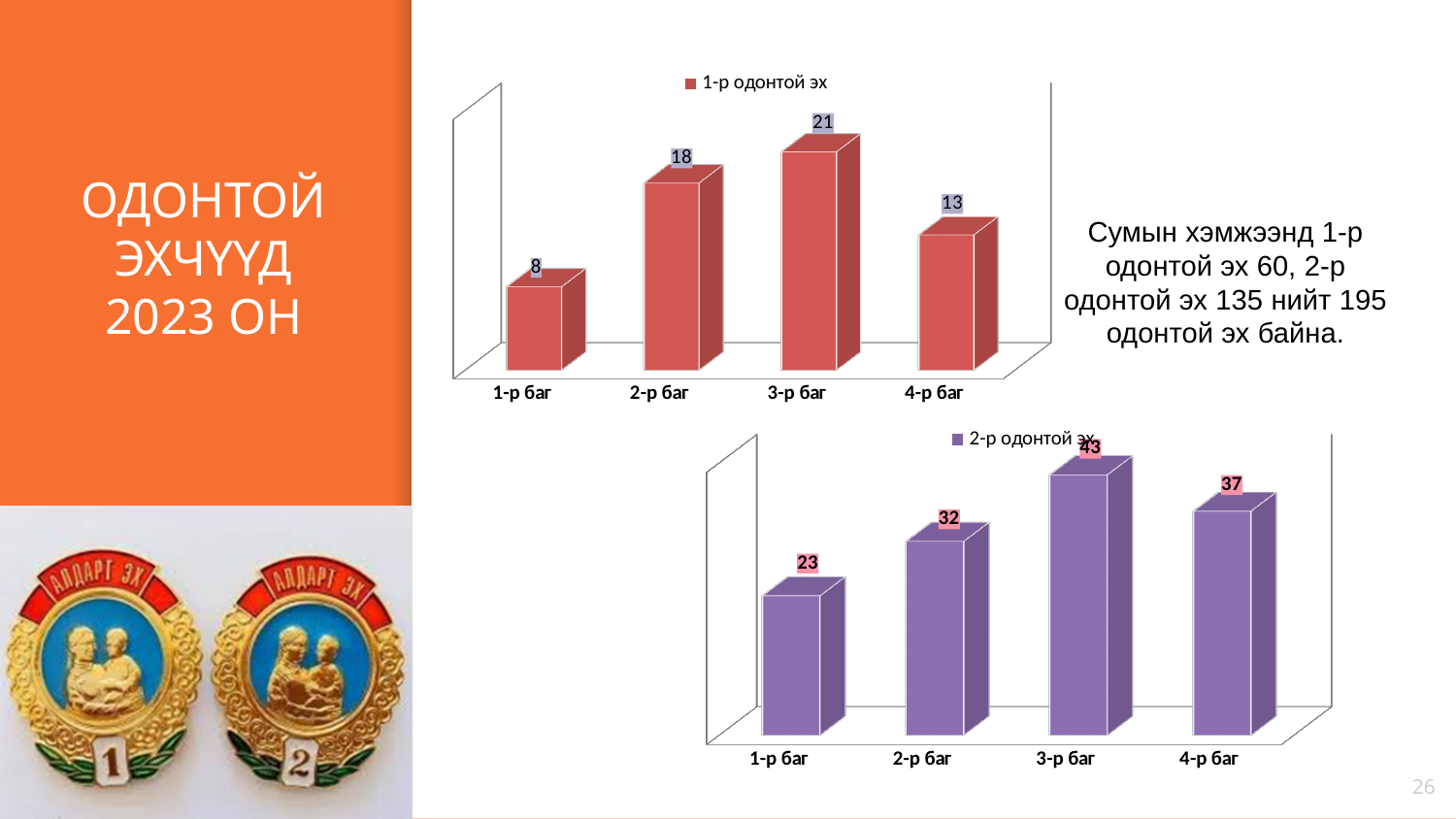
In the bottom chart (2-р одонтой эх), which is larger: the value for 2-р баг or 4-р баг? 4-р баг In the bottom chart (2-р одонтой эх), which category has the highest value? 3-р баг What kind of chart is the bottom chart (2-р одонтой эх)? Bar chart What is the legend entry of the bottom chart? 2-р одонтой эх In the top chart (1-р одонтой эх), what is the value for 1-р баг? 8 In the bottom chart (2-р одонтой эх), what is the value for 4-р баг? 37 How many series does the legend of the top chart list? 1 In the top chart (1-р одонтой эх), what is the difference between the values for 3-р баг and 1-р баг? 13 In the top chart (1-р одонтой эх), what is the value for 3-р баг? 21 How many categories are shown in the top chart (1-р одонтой эх)? 4 In the top chart (1-р одонтой эх), which category has the lowest value? 1-р баг In the bottom chart (2-р одонтой эх), what is the difference between the values for 3-р баг and 2-р баг? 11